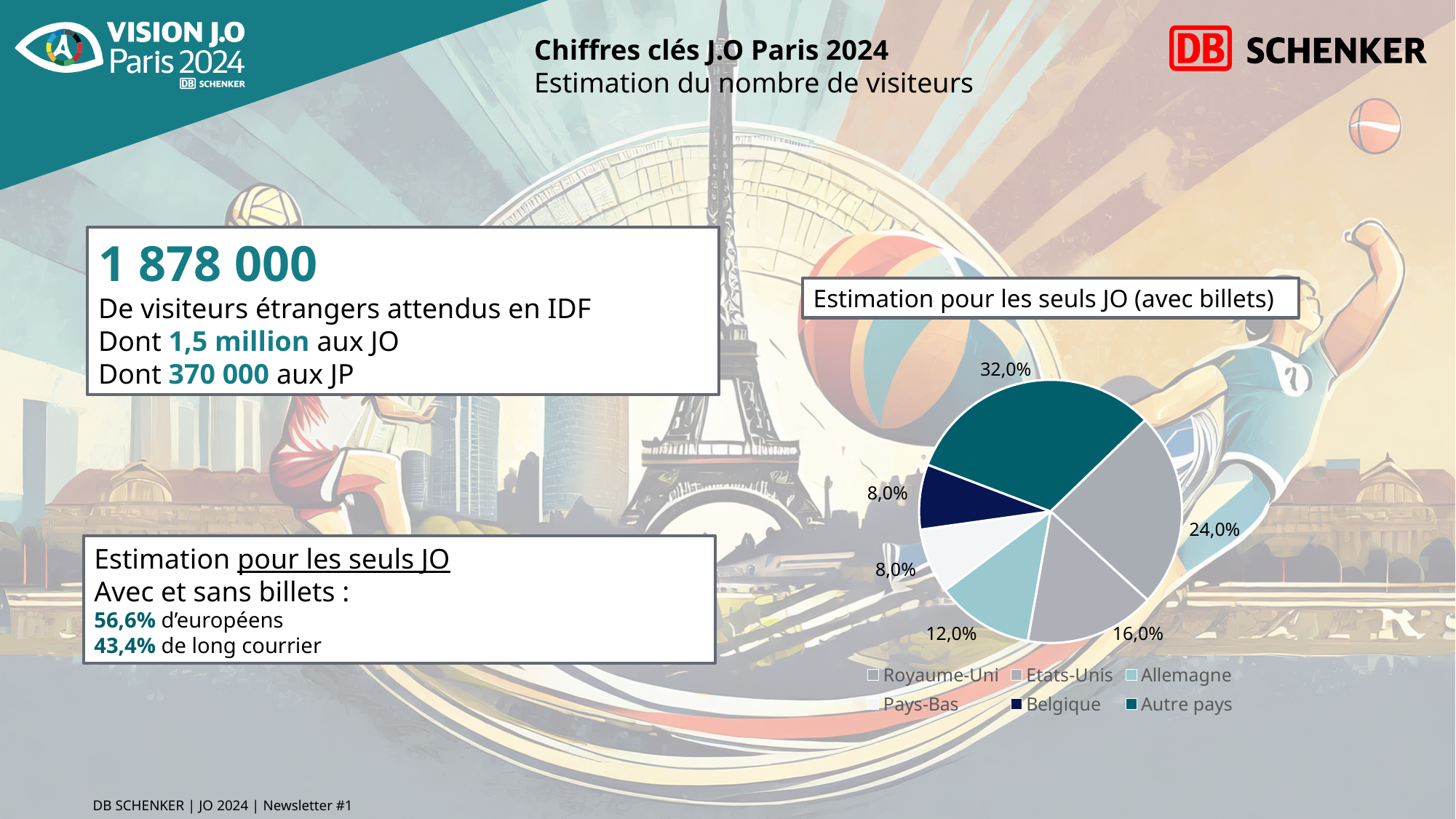
Which category has the largest share of the pie chart? Autre pays What is the title of the pie chart? Estimation pour les seuls JO (avec billets) What share of the pie chart is Pays-Bas? 8,0% What colour is the Autre pays slice in the pie chart? Dark teal What share of the pie chart is Belgique? 8,0% How many slices does the pie chart have? 6 How many entries does the pie chart's legend list? 6 What share of the pie chart is Allemagne? 12,0% What is the difference between the share for Autre pays and the share for Allemagne in the pie chart? 20,0% What kind of chart is shown on the slide? Pie chart Which is larger in the pie chart, the share for Allemagne or the share for Belgique? Allemagne What share of the pie chart is Autre pays? 32,0%